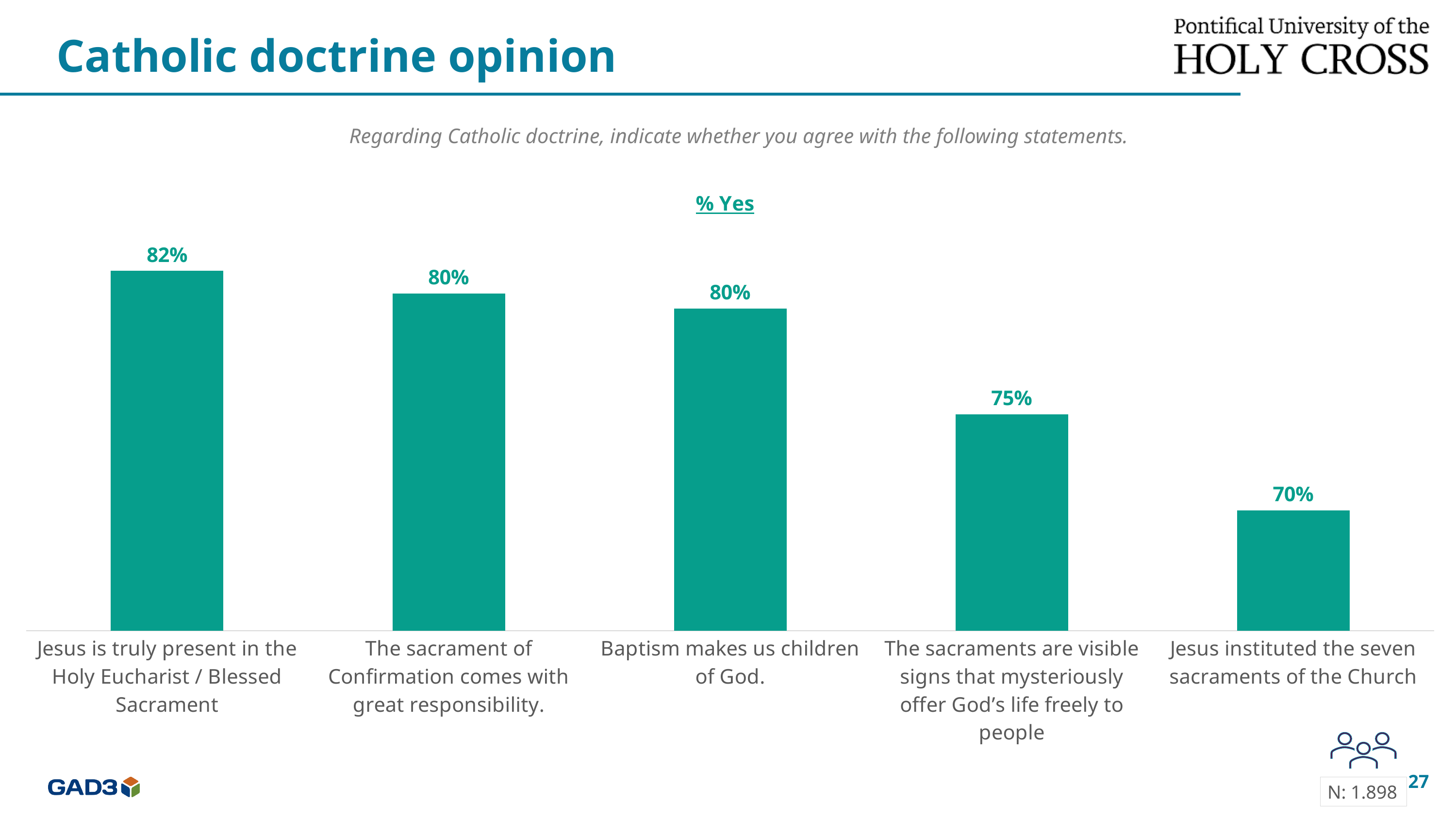
What type of chart is shown on the slide? Bar chart What is the difference in % Yes between the highest and lowest statements? 12% Which has a higher % Yes: 'Baptism makes us children of God.' or 'Jesus instituted the seven sacraments of the Church'? Baptism makes us children of God. What is the % Yes value for the statement 'Jesus instituted the seven sacraments of the Church'? 70% Which statement has the lowest % Yes? Jesus instituted the seven sacraments of the Church What is the % Yes value for 'Baptism makes us children of God.'? 80% How many statements are shown in the chart? 5 Do the values rise or fall from left to right across the chart? Fall What percentage agree that the sacraments are visible signs that mysteriously offer God's life freely to people? 75% Which statement has the highest % Yes? Jesus is truly present in the Holy Eucharist / Blessed Sacrament What percentage of respondents agree that Jesus is truly present in the Holy Eucharist / Blessed Sacrament? 82% What is the difference between the % Yes for 'The sacrament of Confirmation comes with great responsibility.' and 'The sacraments are visible signs that mysteriously offer God's life freely to people'? 5%